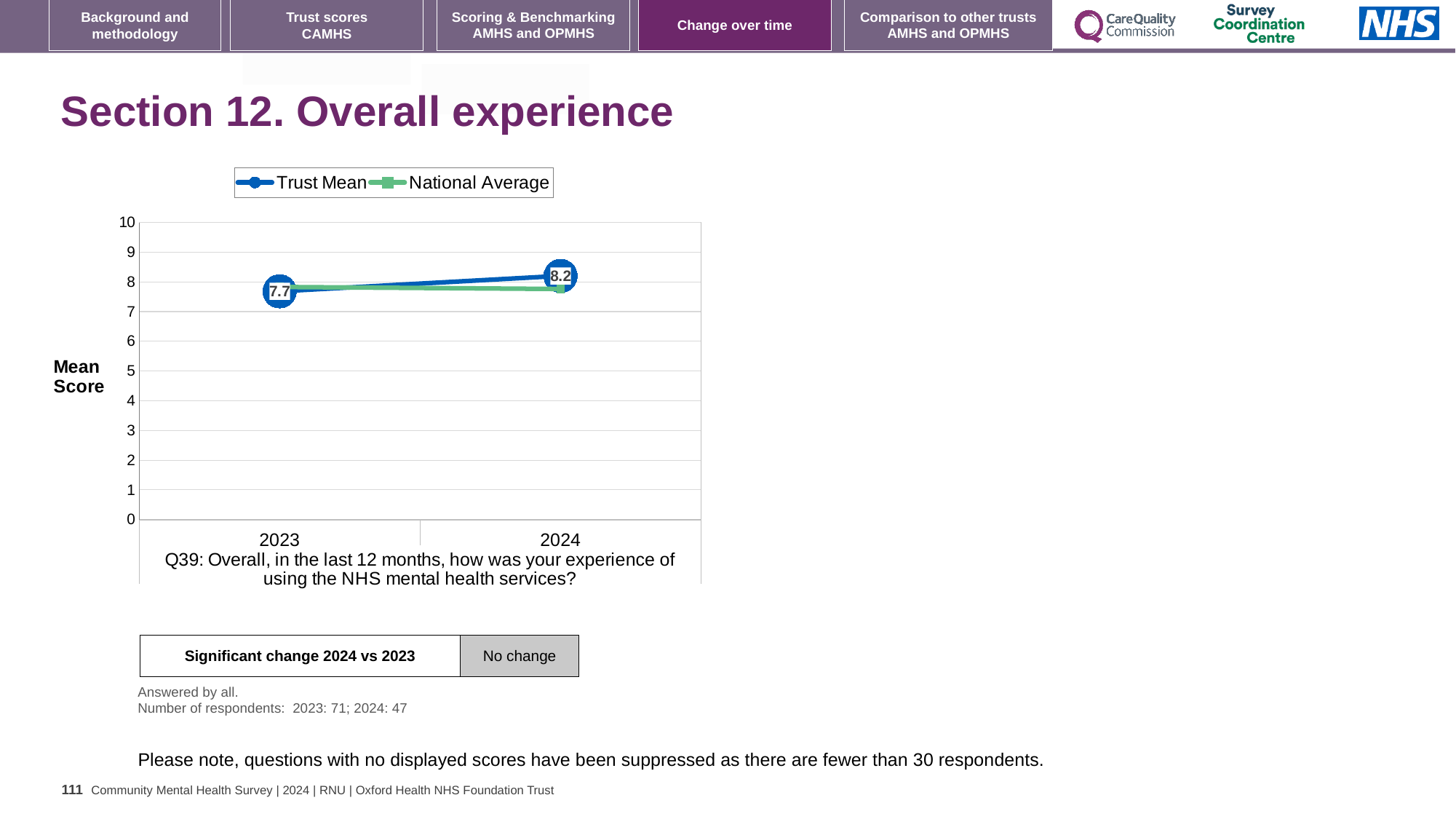
What is the Trust Mean score for 2023? 7.7 Does the Trust Mean line rise or fall from 2023 to 2024? rise What is the label on the y axis of the chart? Mean Score Which year has the higher Trust Mean score, 2023 or 2024? 2024 Is the National Average value for 2023 greater or less than 9? less By how much did the Trust Mean score change from 2023 to 2024? 0.5 Is the National Average value for 2024 greater or less than 5? greater What kind of chart is shown on the slide? line chart How many years are plotted on the x axis? 2 What is the Trust Mean score for 2024? 8.2 What are the two series named in the legend? Trust Mean and National Average How many series does the legend list? 2